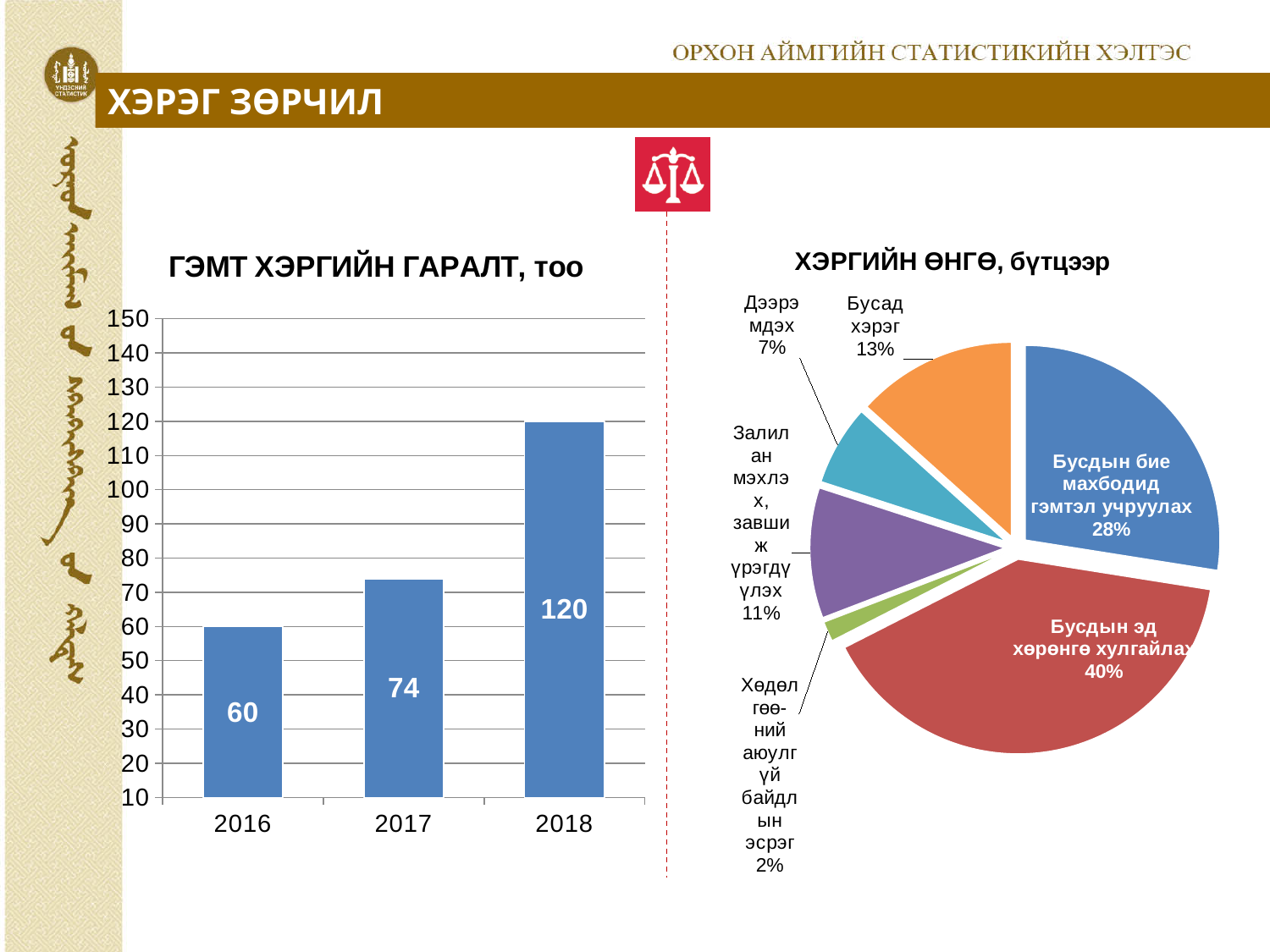
In the bar chart 'ГЭМТ ХЭРГИЙН ГАРАЛТ, тоо', how many years are shown on the x axis? 3 In the pie chart 'ХЭРГИЙН ӨНГӨ, бүтцээр', what share does 'Бусад хэрэг' have? 13% In the bar chart 'ГЭМТ ХЭРГИЙН ГАРАЛТ, тоо', which year has the lowest value? 2016 In the bar chart 'ГЭМТ ХЭРГИЙН ГАРАЛТ, тоо', do the values rise or fall from 2016 to 2018? rise In the bar chart 'ГЭМТ ХЭРГИЙН ГАРАЛТ, тоо', what is the value for 2017? 74 In the bar chart 'ГЭМТ ХЭРГИЙН ГАРАЛТ, тоо', what is the value for 2018? 120 In the bar chart 'ГЭМТ ХЭРГИЙН ГАРАЛТ, тоо', which year has the highest value? 2018 In the pie chart 'ХЭРГИЙН ӨНГӨ, бүтцээр', what share does 'Бусдын эд хөрөнгө хулгайлах' have? 40% In the pie chart 'ХЭРГИЙН ӨНГӨ, бүтцээр', which category has the smallest slice? Хөдөлгөөний аюулгүй байдлын эсрэг In the pie chart 'ХЭРГИЙН ӨНГӨ, бүтцээр', how many slices are there? 6 What kind of chart is the chart on the left of the slide, 'ГЭМТ ХЭРГИЙН ГАРАЛТ, тоо'? bar chart In the bar chart 'ГЭМТ ХЭРГИЙН ГАРАЛТ, тоо', what is the difference between the values for 2018 and 2016? 60